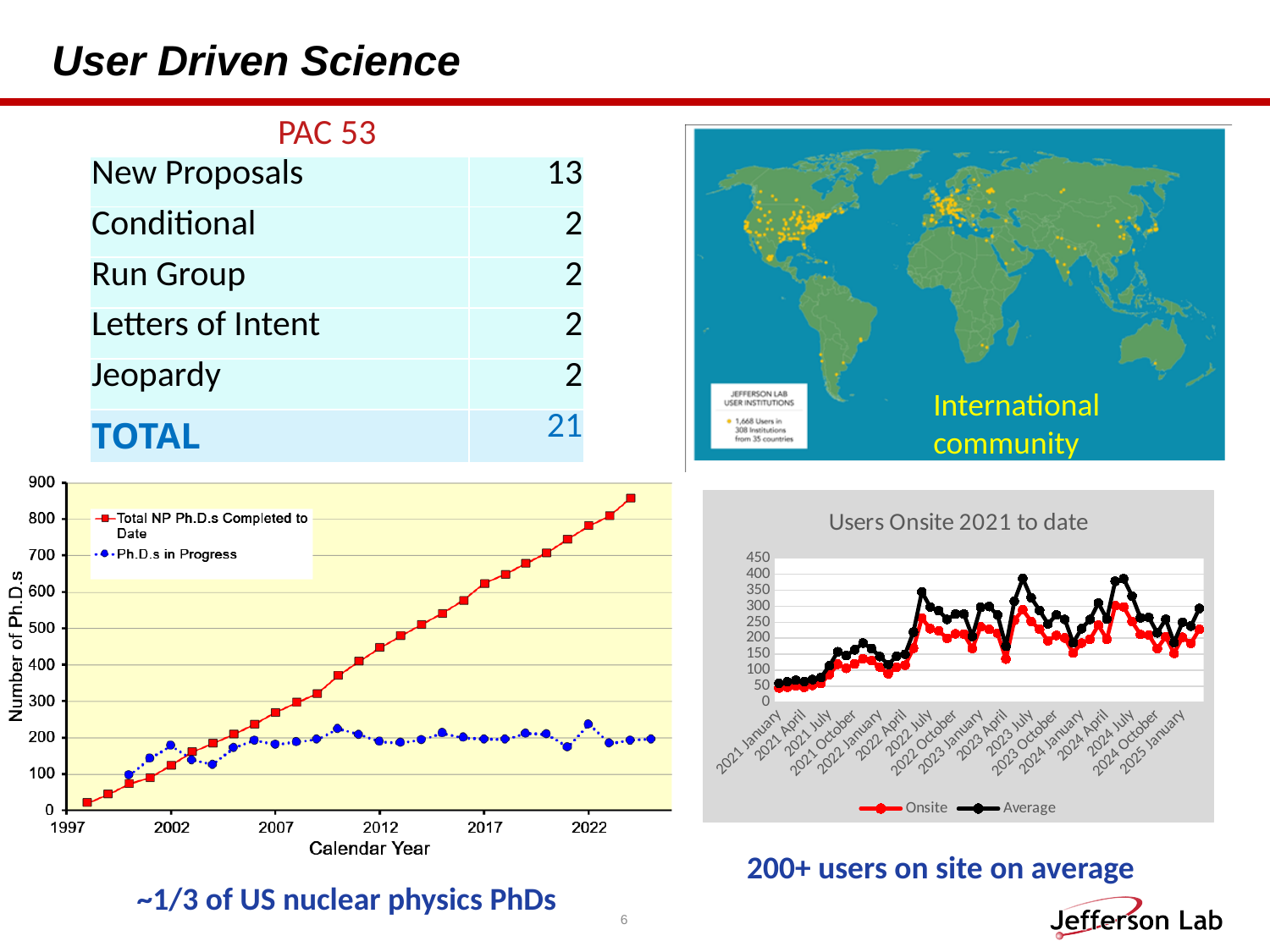
In the bottom-left 'Number of Ph.D.s' chart, is the value of 'Total NP Ph.D.s Completed to Date' in 2022 greater or less than 700? greater In the bottom-left 'Number of Ph.D.s' chart, is the value of 'Ph.D.s in Progress' in 2022 greater or less than 300? less In the bottom-left 'Number of Ph.D.s' chart, which series is higher in 2017: 'Total NP Ph.D.s Completed to Date' or 'Ph.D.s in Progress'? Total NP Ph.D.s Completed to Date How many series does the legend of the bottom-left 'Number of Ph.D.s' chart list? 2 What kind of chart is 'Users Onsite 2021 to date'? line chart In the bottom-left 'Number of Ph.D.s' chart, what is the label of the y axis? Number of Ph.D.s In the bottom-left 'Number of Ph.D.s' chart, does the 'Total NP Ph.D.s Completed to Date' series rise or fall from 1997 to 2022? rise What is the title of the bottom-right chart? Users Onsite 2021 to date In the 'Users Onsite 2021 to date' chart, is the 'Onsite' value in 2021 January greater or less than 100? less How many series does the legend of the 'Users Onsite 2021 to date' chart list? 2 What kind of chart is the bottom-left chart with the 'Calendar Year' axis? line chart